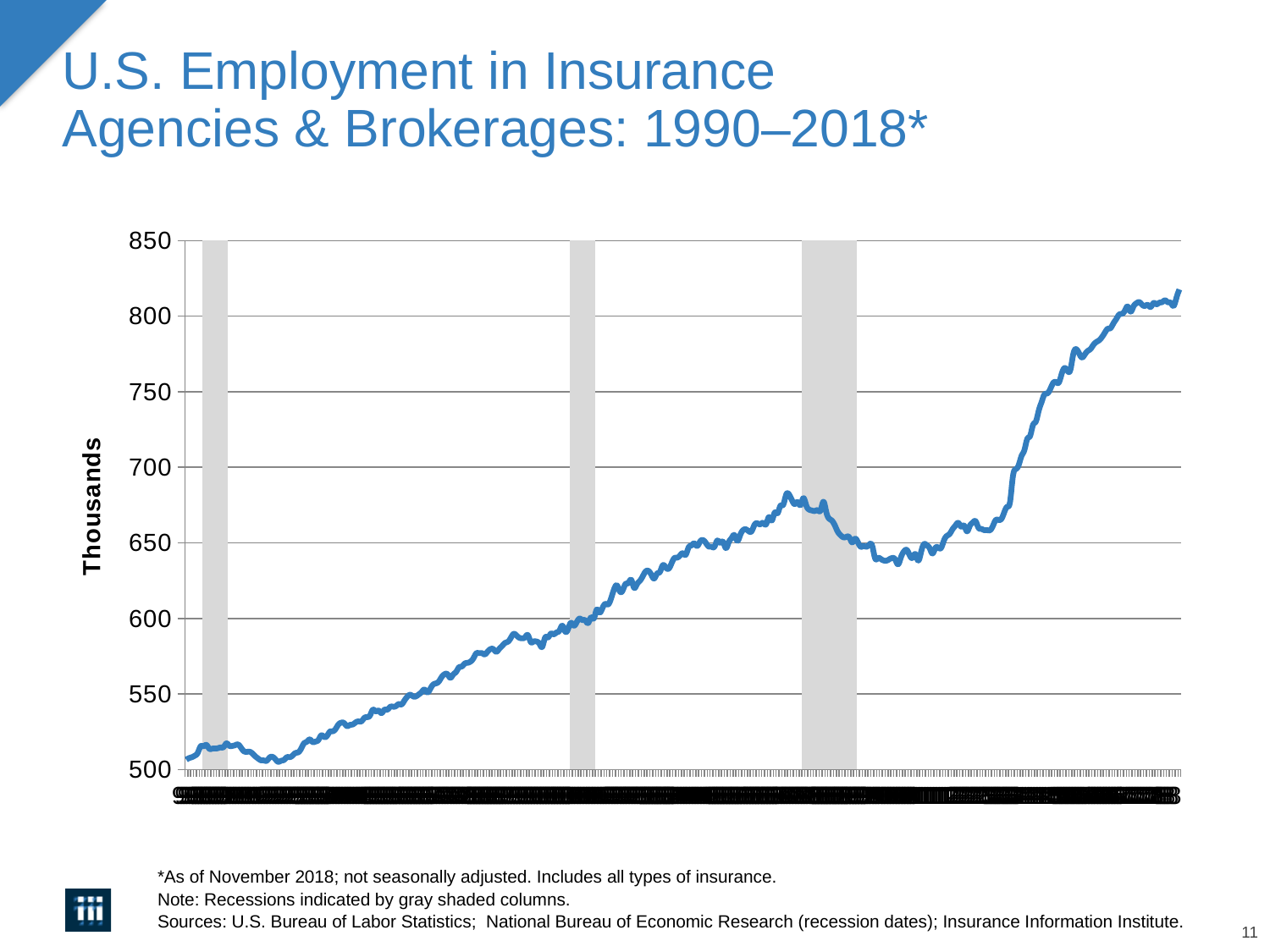
Is the peak of the line just before the third gray recession column greater or less than 700? less What kind of chart is shown on the slide? line chart What is the label on the vertical axis of the chart? Thousands Is the value at the start of the series (1990) greater or less than 550? less How many data series are plotted on the chart? 1 Does the line rise or fall during the third (rightmost) gray recession column? fall Is the value at the end of the series (November 2018) greater or less than 800? greater How many gray shaded recession columns are shown on the chart? 3 What is the title of the chart on the slide? U.S. Employment in Insurance Agencies & Brokerages: 1990–2018* Overall, does employment rise or fall from the start of the series to the end? rise What is the lowest value shown on the vertical axis? 500